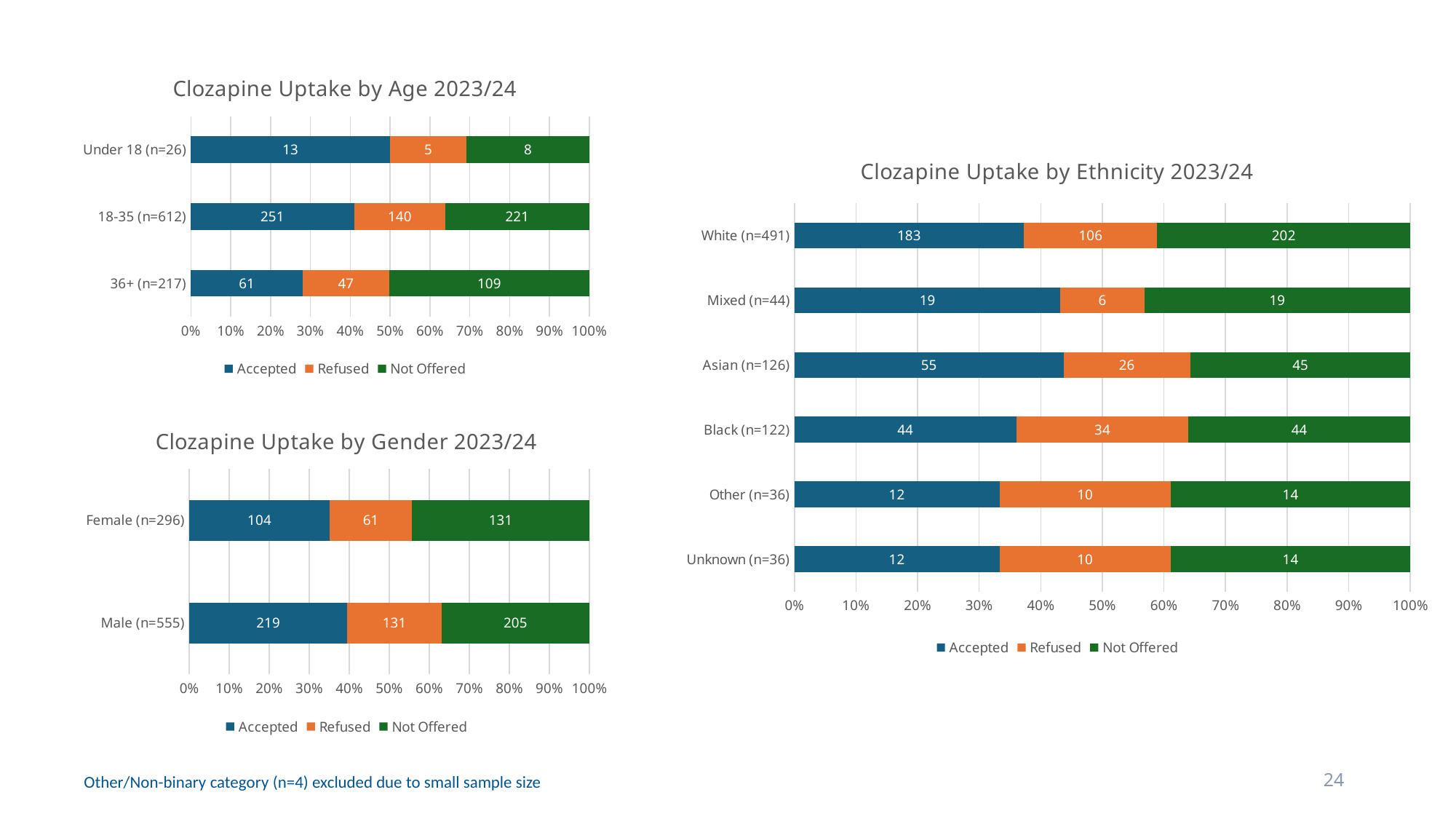
In the Clozapine Uptake by Ethnicity 2023/24 chart, which category has the highest Accepted value? White (n=491) How many series does the legend of the Clozapine Uptake by Age 2023/24 chart list? 3 In the Clozapine Uptake by Ethnicity 2023/24 chart, which is larger, the Refused value for Black or for Asian? Black In the Clozapine Uptake by Age 2023/24 chart, which category has the lowest Refused value? Under 18 (n=26) In the Clozapine Uptake by Gender 2023/24 chart, what is the difference between the Accepted values for Male and Female? 115 In the Clozapine Uptake by Age 2023/24 chart, what is the total of the stacked bar for 36+ (n=217)? 217 In the Clozapine Uptake by Age 2023/24 chart, what is the Accepted value for 18-35 (n=612)? 251 In the Clozapine Uptake by Ethnicity 2023/24 chart, is the Accepted share for White (n=491) greater or less than 30%? greater In the Clozapine Uptake by Ethnicity 2023/24 chart, what is the Refused value for Asian (n=126)? 26 In the Clozapine Uptake by Gender 2023/24 chart, what is the Not Offered value for Male (n=555)? 205 What kind of chart is the Clozapine Uptake by Gender 2023/24 chart? Stacked bar chart How many categories are shown in the Clozapine Uptake by Ethnicity 2023/24 chart? 6